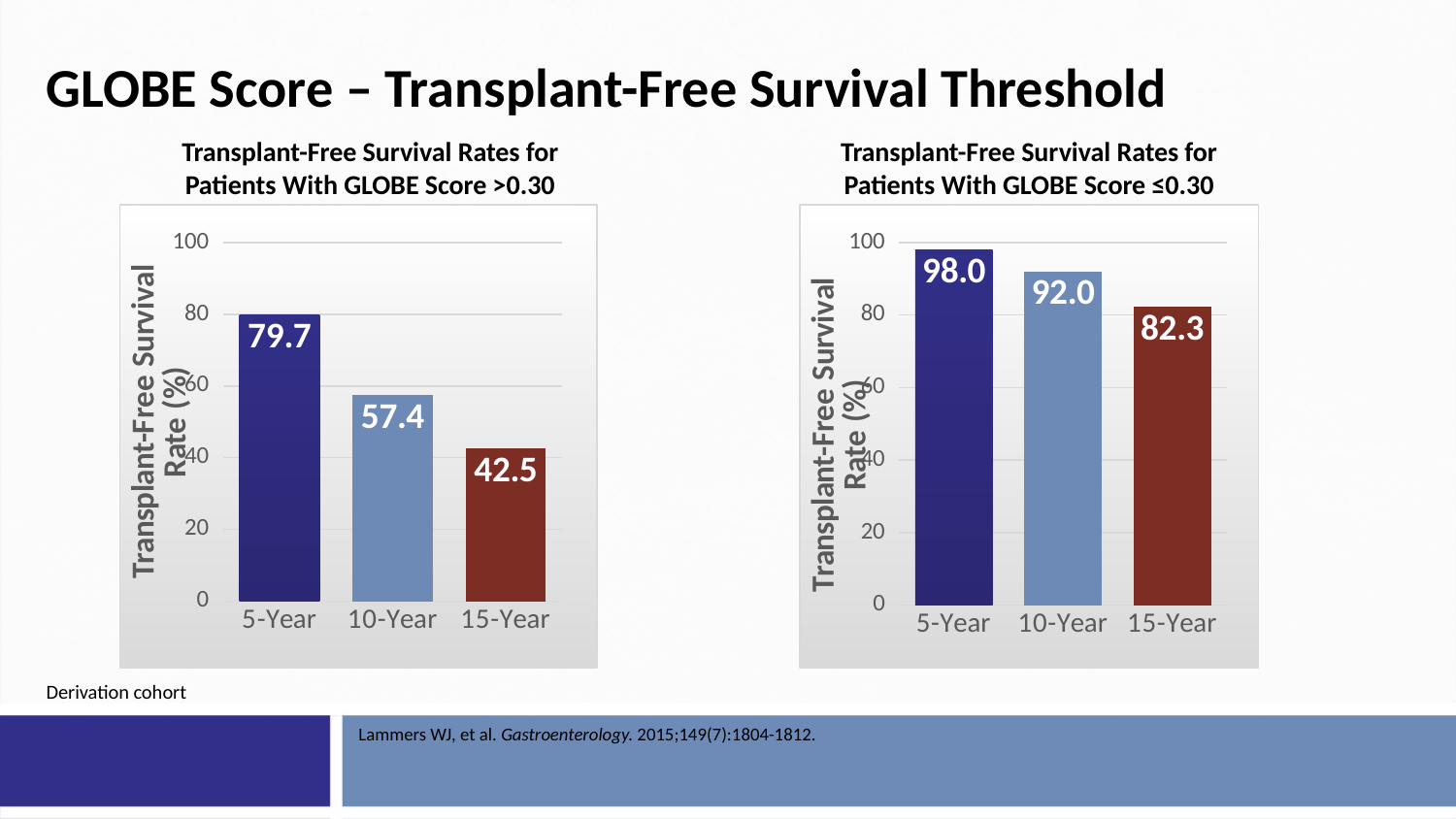
In the chart 'Transplant-Free Survival Rates for Patients With GLOBE Score >0.30', is the 10-Year survival rate greater or less than 60? less In the chart 'Transplant-Free Survival Rates for Patients With GLOBE Score >0.30', what is the 5-Year survival rate? 79.7 In the chart 'Transplant-Free Survival Rates for Patients With GLOBE Score >0.30', which time point has the highest survival rate? 5-Year How many time points are shown in the chart 'Transplant-Free Survival Rates for Patients With GLOBE Score ≤0.30'? 3 What type of chart is 'Transplant-Free Survival Rates for Patients With GLOBE Score >0.30'? Bar chart In the chart 'Transplant-Free Survival Rates for Patients With GLOBE Score >0.30', what is the 15-Year survival rate? 42.5 In the chart 'Transplant-Free Survival Rates for Patients With GLOBE Score ≤0.30', which time point has the lowest survival rate? 15-Year In the chart 'Transplant-Free Survival Rates for Patients With GLOBE Score ≤0.30', what is the difference between the 5-Year and 15-Year survival rates? 15.7 In the chart 'Transplant-Free Survival Rates for Patients With GLOBE Score ≤0.30', what is the 10-Year survival rate? 92.0 In the chart 'Transplant-Free Survival Rates for Patients With GLOBE Score >0.30', what is the difference between the 5-Year and 10-Year survival rates? 22.3 In the chart 'Transplant-Free Survival Rates for Patients With GLOBE Score ≤0.30', do the survival rates rise or fall from 5-Year to 15-Year? Fall Which is larger: the 10-Year survival rate in the GLOBE Score >0.30 chart or the 10-Year survival rate in the GLOBE Score ≤0.30 chart? GLOBE Score ≤0.30